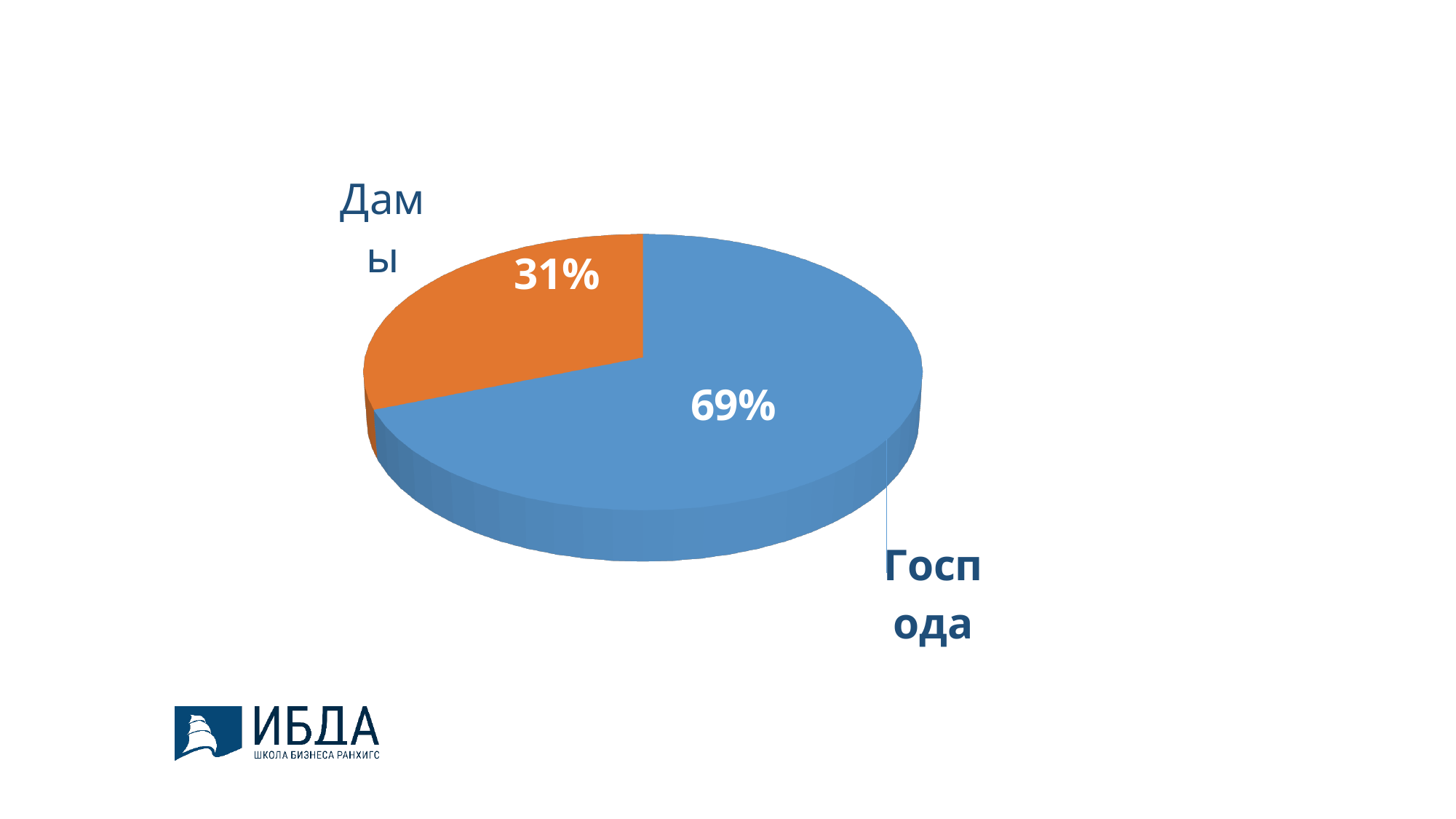
What colour is the Дамы slice? orange What colour is the Господа slice? blue What is the difference in percentage points between the Господа slice and the Дамы slice? 38 Which slice is the largest in the pie chart? Господа Which slice is the smallest in the pie chart? Дамы Which is larger, the Дамы slice or the Господа slice? Господа How many slices does the pie chart have? 2 What kind of chart is shown on the slide? pie chart What share of the pie does the Господа slice represent? 69% What share of the pie does the Дамы slice represent? 31%